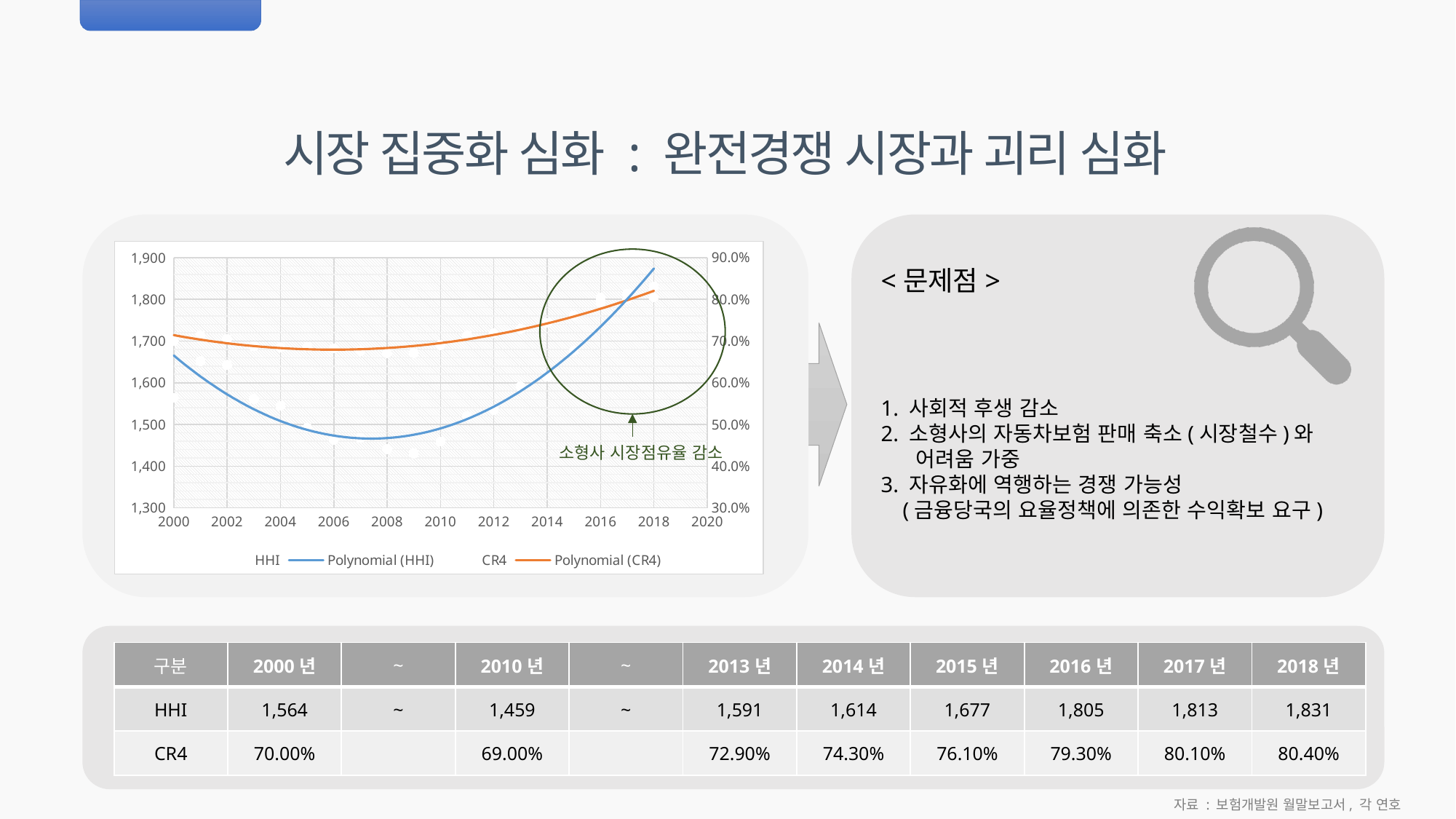
Among the years listed in the table, which year has the lowest HHI value? 2010 Is the CR4 value for 2000 greater or less than 60.0% on the right axis? greater Does the Polynomial (HHI) line rise or fall between 2000 and 2006? falls What are the two series names (excluding the polynomial trendlines) in the chart legend? HHI and CR4 According to the table, what is the CR4 value for 2014? 74.30% Among the years listed in the table, which year has the highest CR4 value? 2018 How many entries does the chart legend list? 4 Does the Polynomial (CR4) line rise or fall between 2010 and 2018? rises According to the table, what is the HHI value for 2018? 1,831 What is the difference between the HHI value in 2018 and in 2000, as shown in the table? 267 What kind of chart is shown on the left of the slide? line chart What text is written in the annotation below the circled area of the chart? 소형사 시장점유율 감소